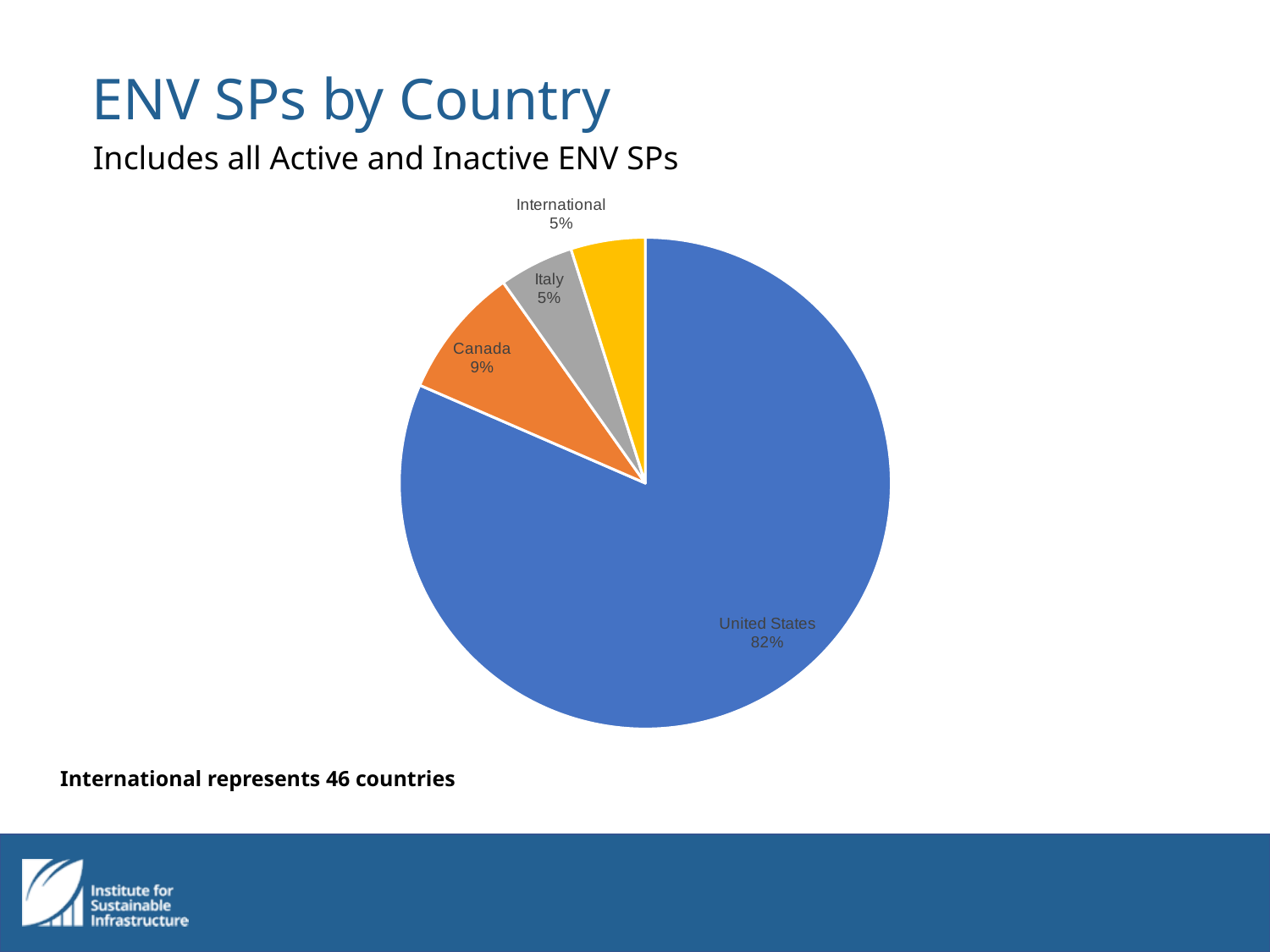
How many slices does the pie chart have? 4 What share of ENV SPs is from Canada? 9% What share of ENV SPs is labelled International? 5% What type of chart is shown on the slide? pie chart What is the difference in percentage points between the Canada and Italy slices? 4 What share of ENV SPs is from Italy? 5% What colour is the United States slice? blue Which category has the largest slice of the pie? United States What is the title of the chart slide? ENV SPs by Country Which slice is larger, Canada or Italy? Canada What is the difference in percentage points between the United States and Canada slices? 73